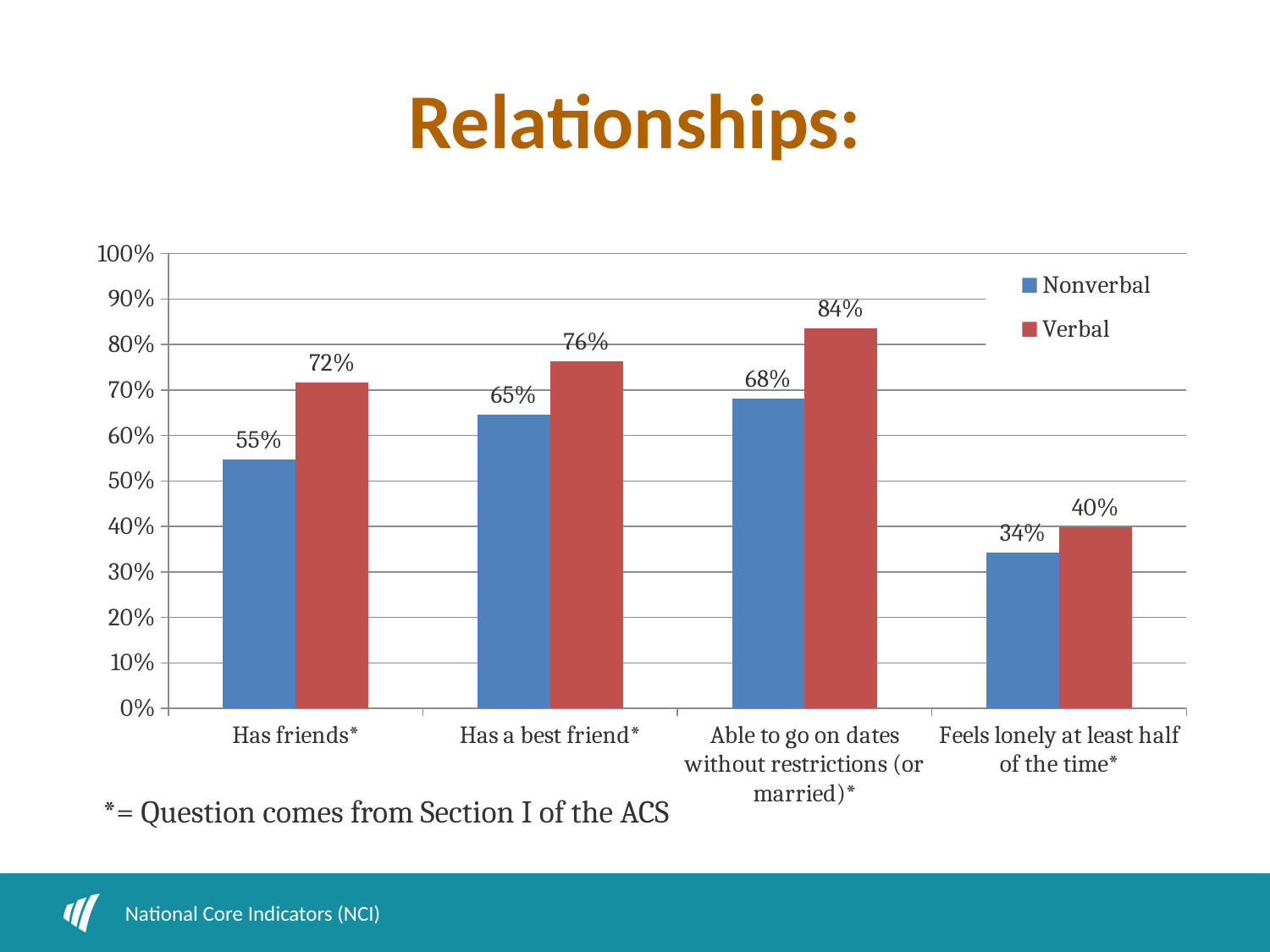
What is the difference between the Verbal and Nonverbal values for "Has friends*"? 17% What colour represents the Verbal series? Red Which category has the highest Verbal value? Able to go on dates without restrictions (or married)* What is the difference between the Verbal and Nonverbal values for "Able to go on dates without restrictions (or married)*"? 16% How many categories are shown on the x axis? 4 Which is larger for "Has a best friend*": the Nonverbal value or the Verbal value? Verbal What is the Verbal value for "Able to go on dates without restrictions (or married)*"? 84% What is the Verbal value for "Feels lonely at least half of the time*"? 40% What is the Nonverbal value for "Has friends*"? 55% Which category has the lowest Nonverbal value? Feels lonely at least half of the time* What kind of chart is shown on the slide? Bar chart How many series does the legend list? 2